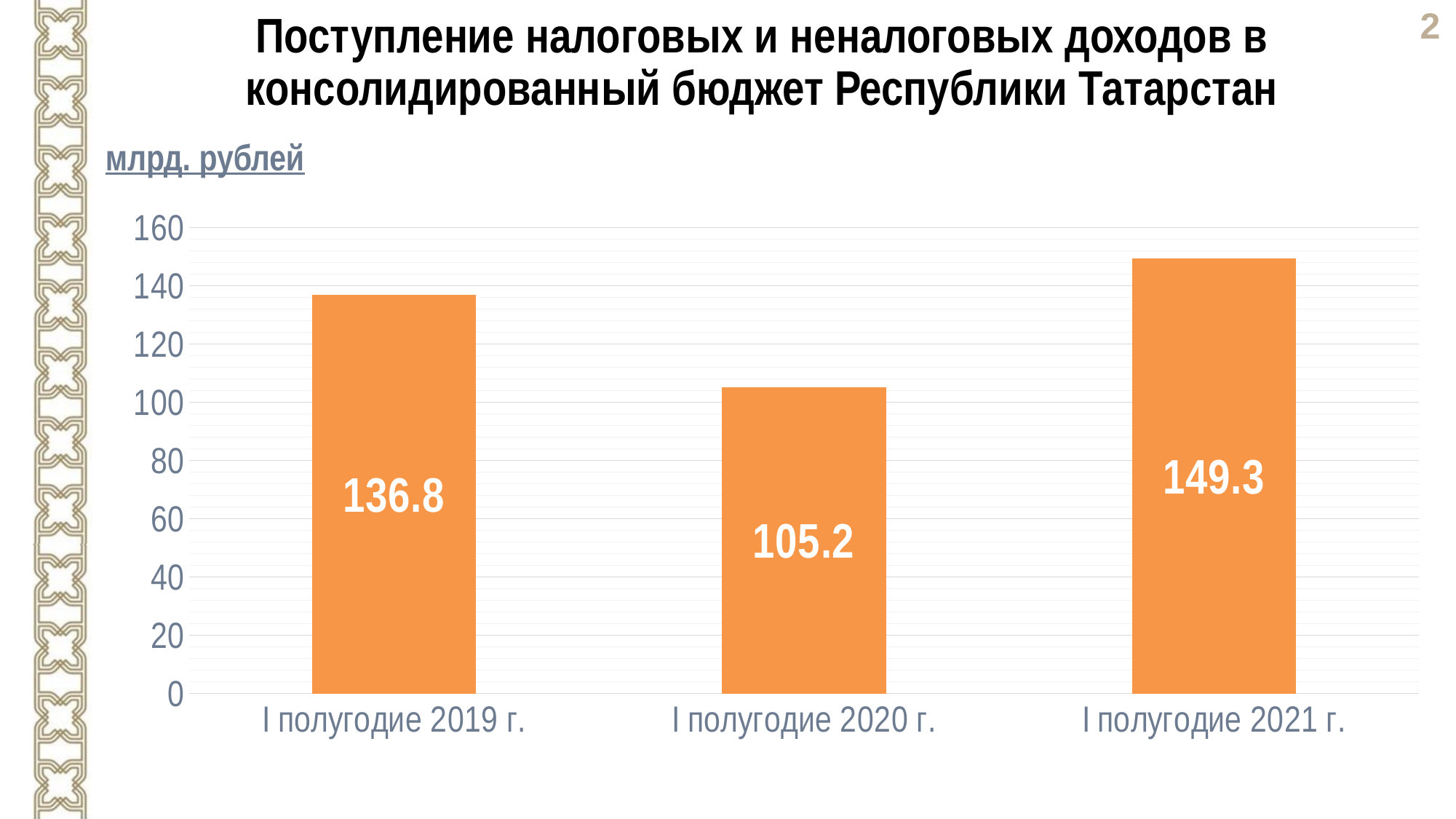
Which is larger, the value for I полугодие 2019 г. or I полугодие 2021 г.? I полугодие 2021 г. What is the difference between the values for I полугодие 2019 г. and I полугодие 2020 г.? 31.6 Which period has the lowest value? I полугодие 2020 г. Is the value for I полугодие 2020 г. greater or less than 120? less What is the value for I полугодие 2020 г.? 105.2 What kind of chart is shown on the slide? bar chart What unit of measurement is indicated above the chart? млрд. рублей Which period has the highest value? I полугодие 2021 г. How many periods are shown on the chart? 3 What is the value for I полугодие 2019 г.? 136.8 What is the difference between the values for I полугодие 2021 г. and I полугодие 2020 г.? 44.1 What is the value for I полугодие 2021 г.? 149.3